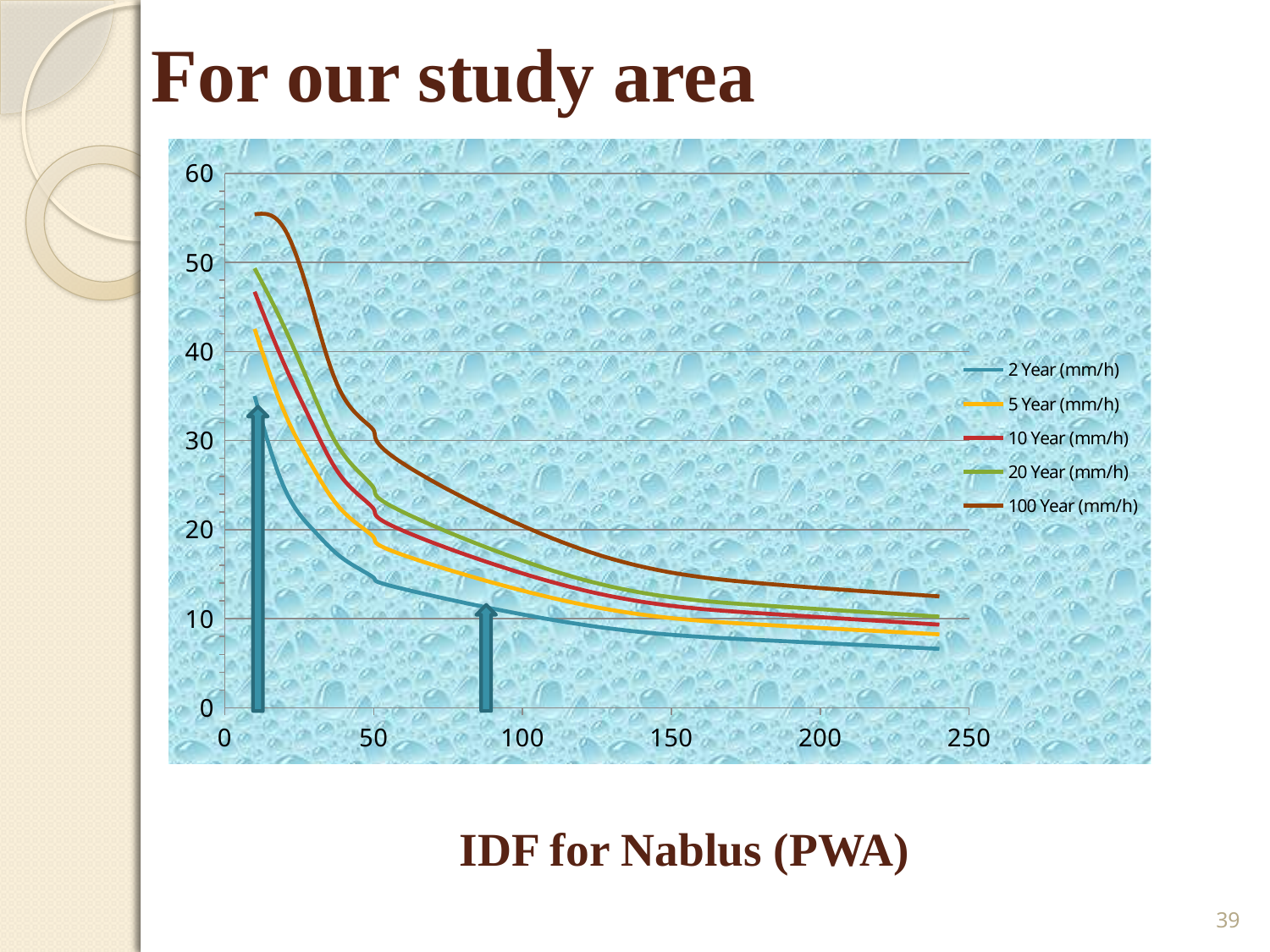
Which series has the highest values across the chart? 100 Year (mm/h) Do the values of the 100 Year (mm/h) series rise or fall as the x axis increases? fall Which series has the lowest values across the chart? 2 Year (mm/h) What is the caption written below the chart? IDF for Nablus (PWA) At x = 100, which series has the larger value, 100 Year (mm/h) or 2 Year (mm/h)? 100 Year (mm/h) Is the value of the 100 Year (mm/h) series at x = 240 greater or less than 10? greater What is the highest value shown on the y axis? 60 What kind of chart is shown on the slide? line chart Is the value of the 2 Year (mm/h) series at x = 240 greater or less than 10? less How many series does the legend list? 5 Is the value of the 100 Year (mm/h) series at x = 10 greater or less than 50? greater